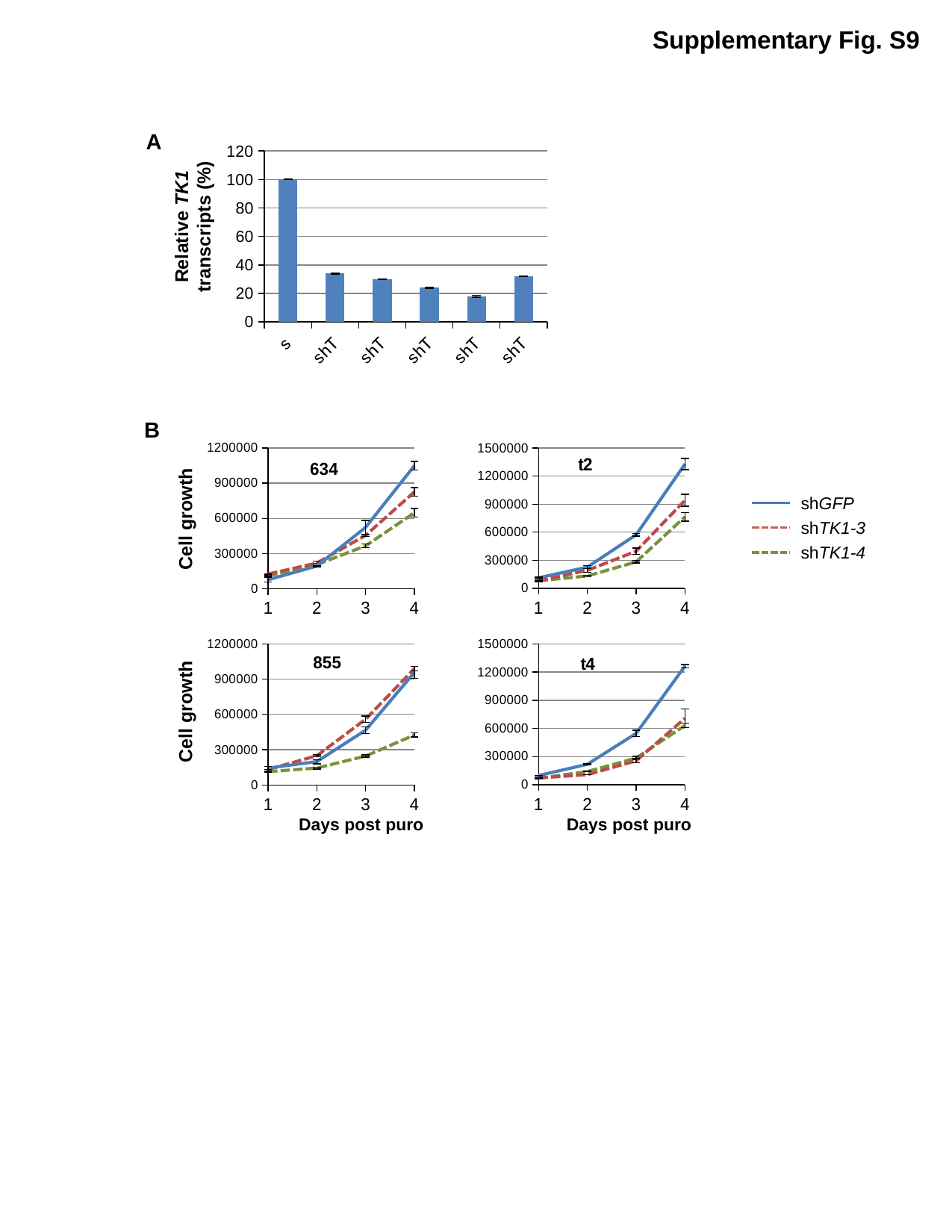
In panel A, is the value of the fourth bar from the left greater or less than 20? greater In the panel B chart labelled 855, is the shTK1-4 value at day 4 greater or less than 600000? less In panel A, which bar is the highest? the leftmost bar In panel A, is the value of the second bar from the left greater or less than 40? less How many series does the legend for panel B list? 3 In panel A, what is the value of the leftmost bar? 100 In panel A, which bar is the lowest? the fifth bar from the left What kind of chart is panel A? bar chart What kind of charts are shown in panel B? line charts How many bars are plotted in panel A? 6 In the panel B chart labelled t4, which series has the highest value at day 4? shGFP